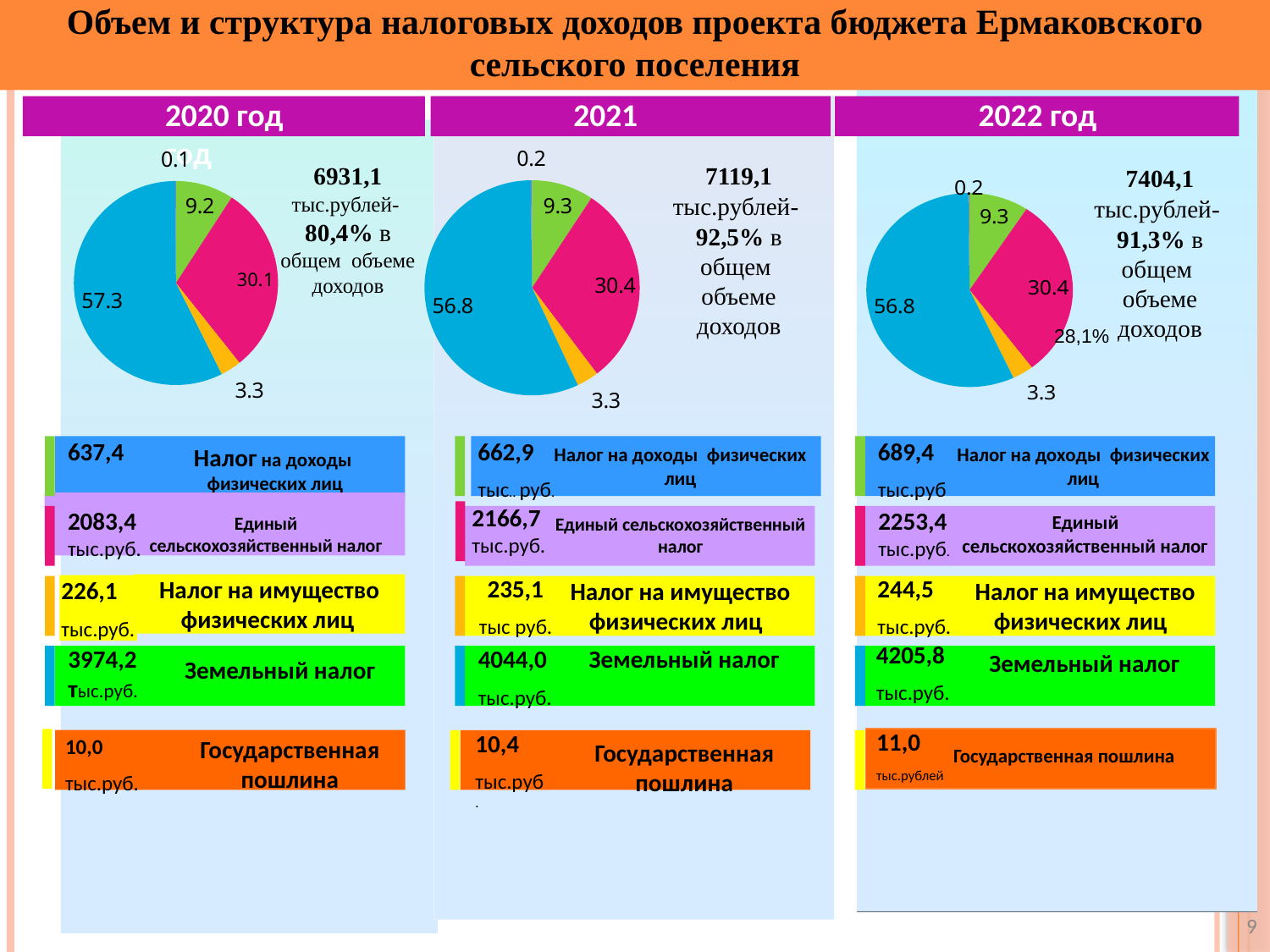
In the 2020 год pie chart, what is the value of the largest slice? 57.3 In the 2020 год pie chart, what is the value of the green slice? 9.2 In the 2021 pie chart, what is the value of the pink slice? 30.4 In the 2022 год pie chart, what is the value of the green slice? 9.3 How many slices does the 2020 год pie chart have? 5 In the 2022 год pie chart, what is the value of the largest slice? 56.8 In the 2021 pie chart, what is the value of the orange slice? 3.3 In the 2020 год pie chart, which slice is larger, the blue one or the pink one? the blue one (57.3) In the 2020 год pie chart, what is the value of the smallest slice? 0.1 What kind of chart is used for the 2020 год, 2021 and 2022 год panels? pie chart In the 2020 год pie chart, what is the difference between the largest slice (57.3) and the pink slice (30.1)? 27.2 How many pie charts are shown on the slide? 3